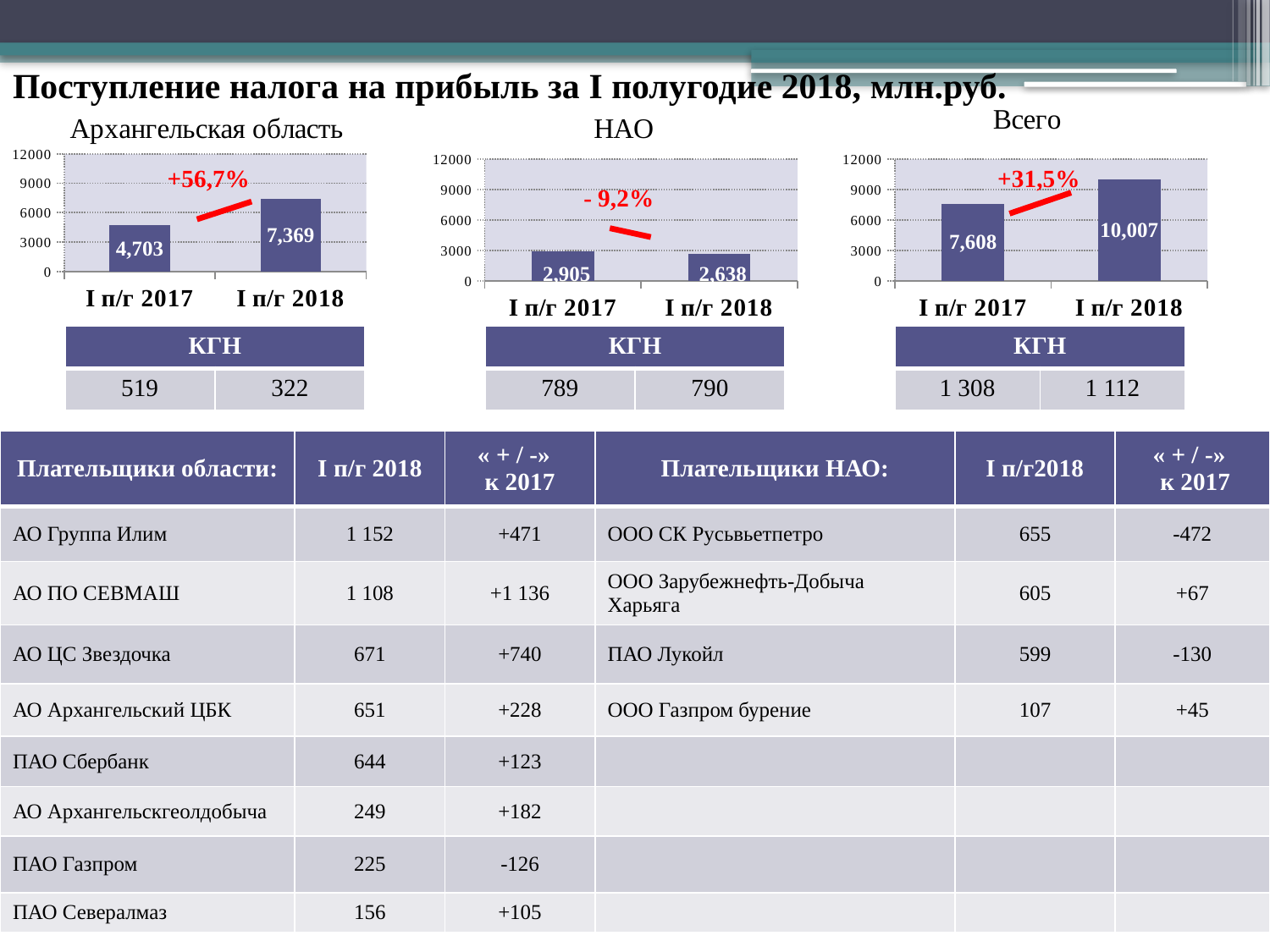
What type of chart is the chart titled "Всего"? bar chart In the chart titled "НАО", is the value for I п/г 2017 greater or less than 6000? less In the chart titled "Архангельская область", which period has the higher value? I п/г 2018 In the chart titled "НАО", what is the value for I п/г 2017? 2,905 How many bars are plotted in the chart titled "НАО"? 2 In the chart titled "Всего", is the value for I п/г 2018 greater or less than 9000? greater In the chart titled "НАО", which period has the lower value? I п/г 2018 In the chart titled "Всего", what is the value for I п/г 2018? 10,007 In the chart titled "Архангельская область", what is the difference between the I п/г 2018 and I п/г 2017 values? 2,666 In the chart titled "НАО", do the values rise or fall from I п/г 2017 to I п/г 2018? fall In the chart titled "Архангельская область", what is the value for I п/г 2018? 7,369 In the chart titled "Всего", what is the value for I п/г 2017? 7,608